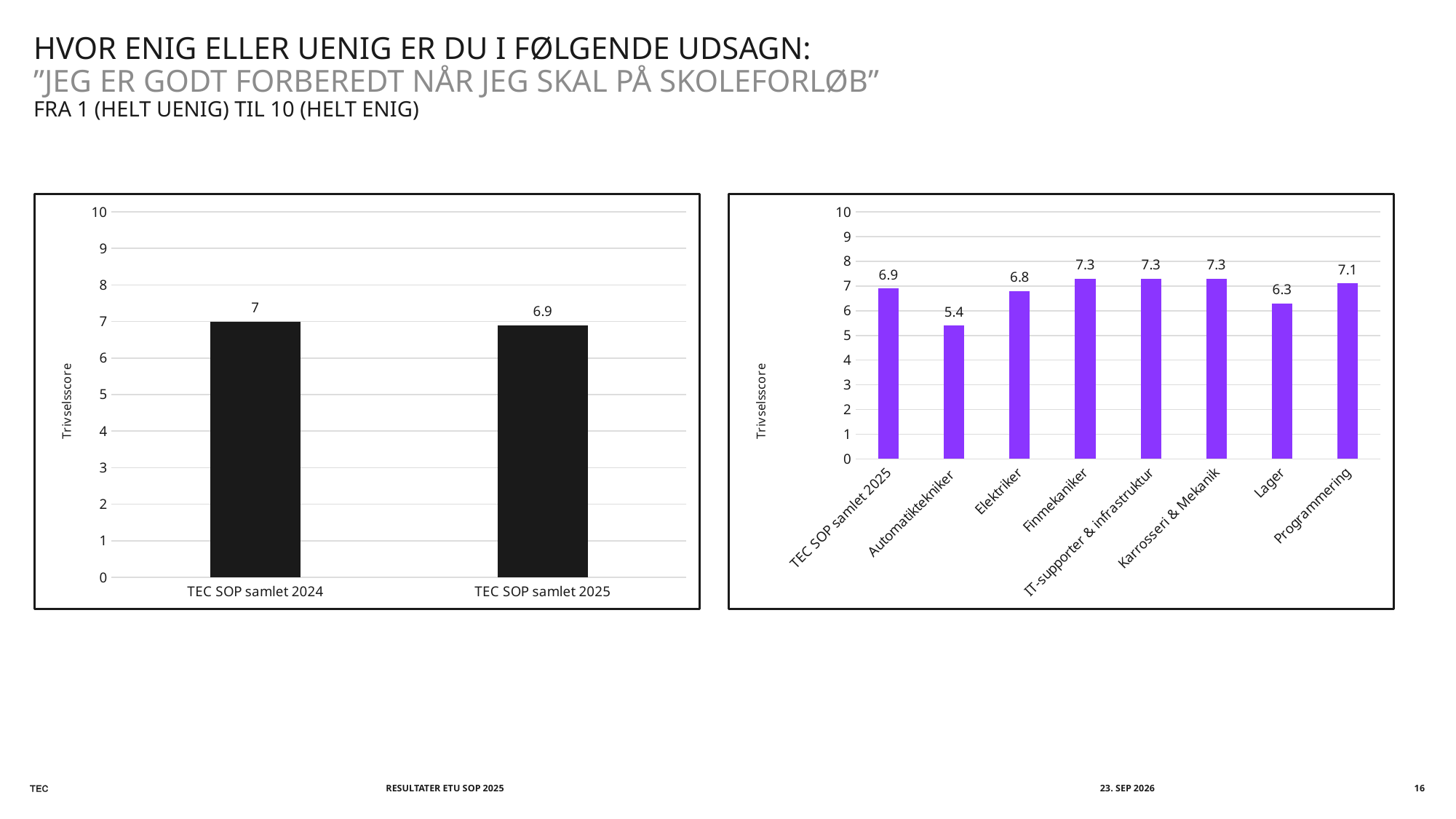
In the left chart, what is the difference between the values for TEC SOP samlet 2024 and TEC SOP samlet 2025? 0.1 In the left chart, how many bars are plotted? 2 In the right chart, which is larger, the value for Elektriker or the value for Lager? Elektriker In the right chart, what is the value for Automatiktekniker? 5.4 In the right chart, what is the value for Programmering? 7.1 In the right chart, what is the value for Lager? 6.3 In the right chart, which category has the lowest value? Automatiktekniker In the right chart, how many categories are plotted? 8 In the left chart, what kind of chart is shown? Bar chart In the left chart, what is the value for TEC SOP samlet 2024? 7 In the left chart, what is the value for TEC SOP samlet 2025? 6.9 In the right chart, what is the difference between the values for Finmekaniker and Automatiktekniker? 1.9